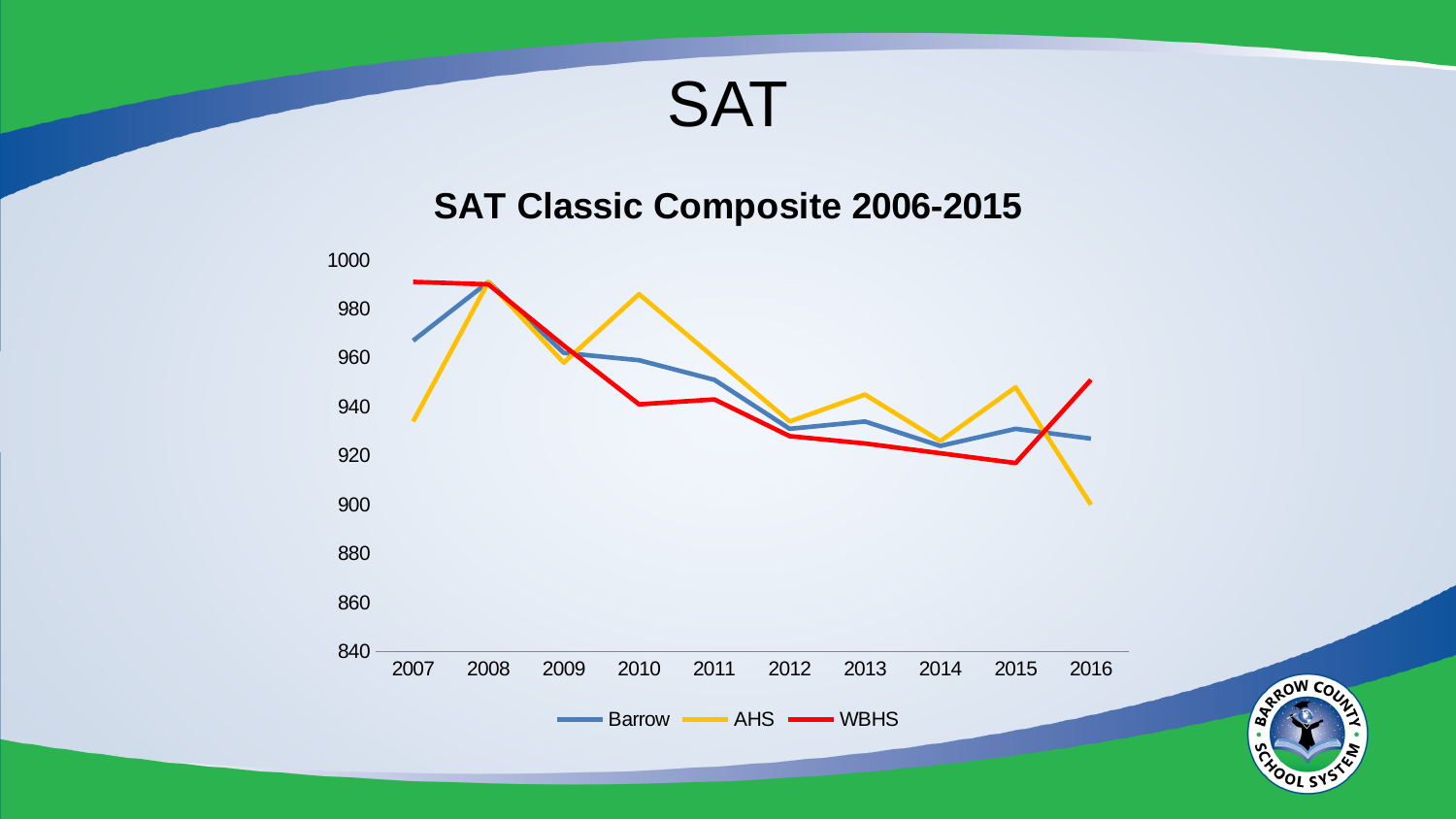
How many years are shown along the x axis? 10 In 2016, which is larger, WBHS or AHS? WBHS Is the value for AHS in 2016 greater or less than 920? less In 2010, which is larger, AHS or WBHS? AHS What kind of chart is shown on the slide? line chart Which series has the lowest value in 2016? AHS What is the title of the chart? SAT Classic Composite 2006-2015 Which series has the highest value in 2010? AHS Is the value for AHS in 2010 greater or less than 960? greater How many series does the legend list? 3 Is the value for Barrow in 2007 greater or less than 960? greater